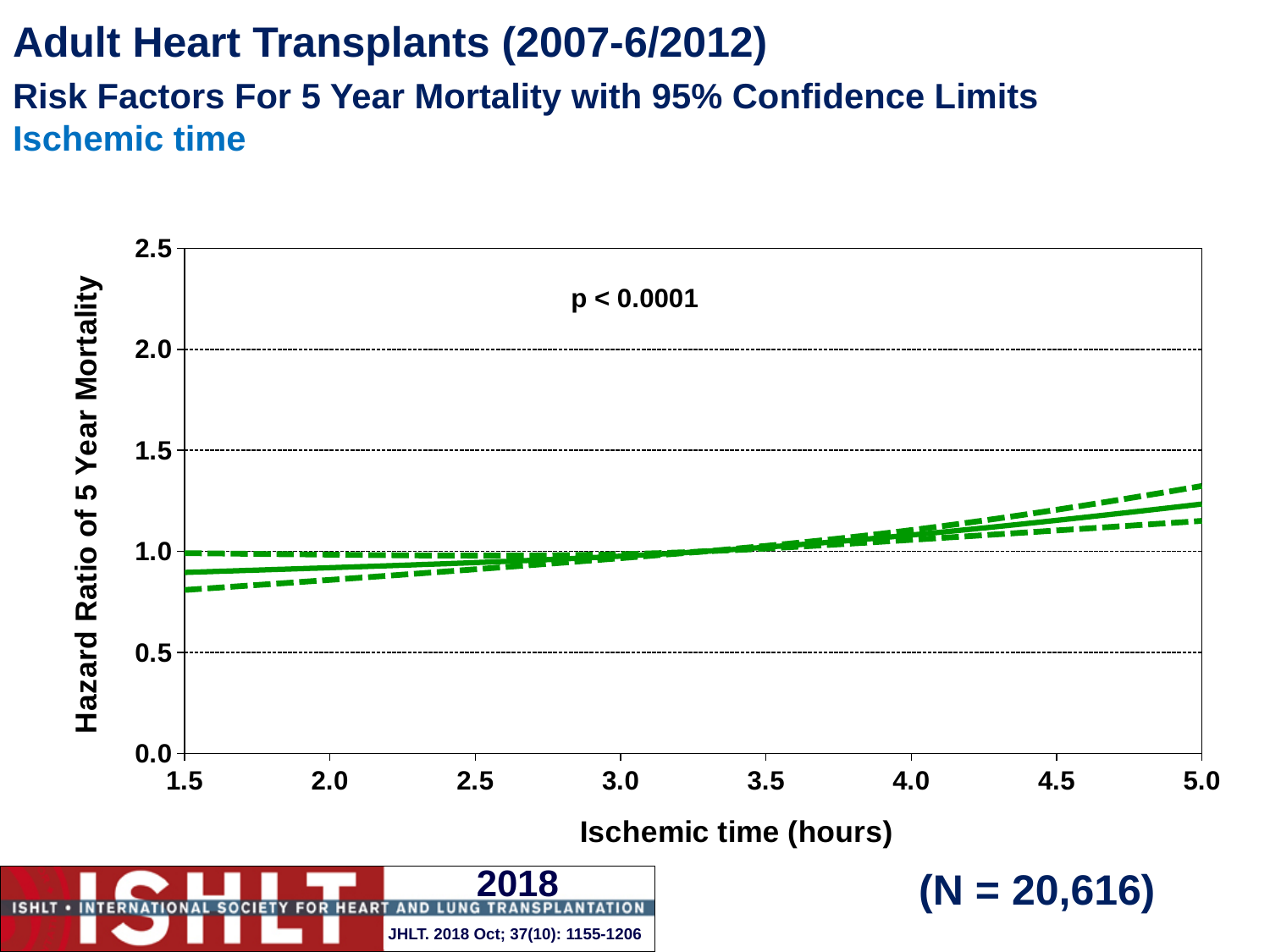
Is the hazard ratio of 5 year mortality at an ischemic time of 5.0 hours greater or less than 1.0? greater Which has the higher hazard ratio of 5 year mortality: an ischemic time of 2.0 hours or 4.5 hours? 4.5 hours Is the upper 95% confidence limit at an ischemic time of 5.0 hours greater or less than 1.5? less What is the lowest ischemic time shown on the x axis of the chart? 1.5 Is the lower 95% confidence limit at an ischemic time of 1.5 hours greater or less than 0.5? greater What p-value is printed on the chart? p < 0.0001 What is the sample size (N) shown on the slide? N = 20,616 Does the hazard ratio of 5 year mortality rise or fall as ischemic time increases from 1.5 to 5.0 hours? Rise What kind of chart is shown on the slide? Line chart How many lines are plotted on the chart (the estimate plus its confidence limits)? 3 What is the highest value shown on the y axis of the chart? 2.5